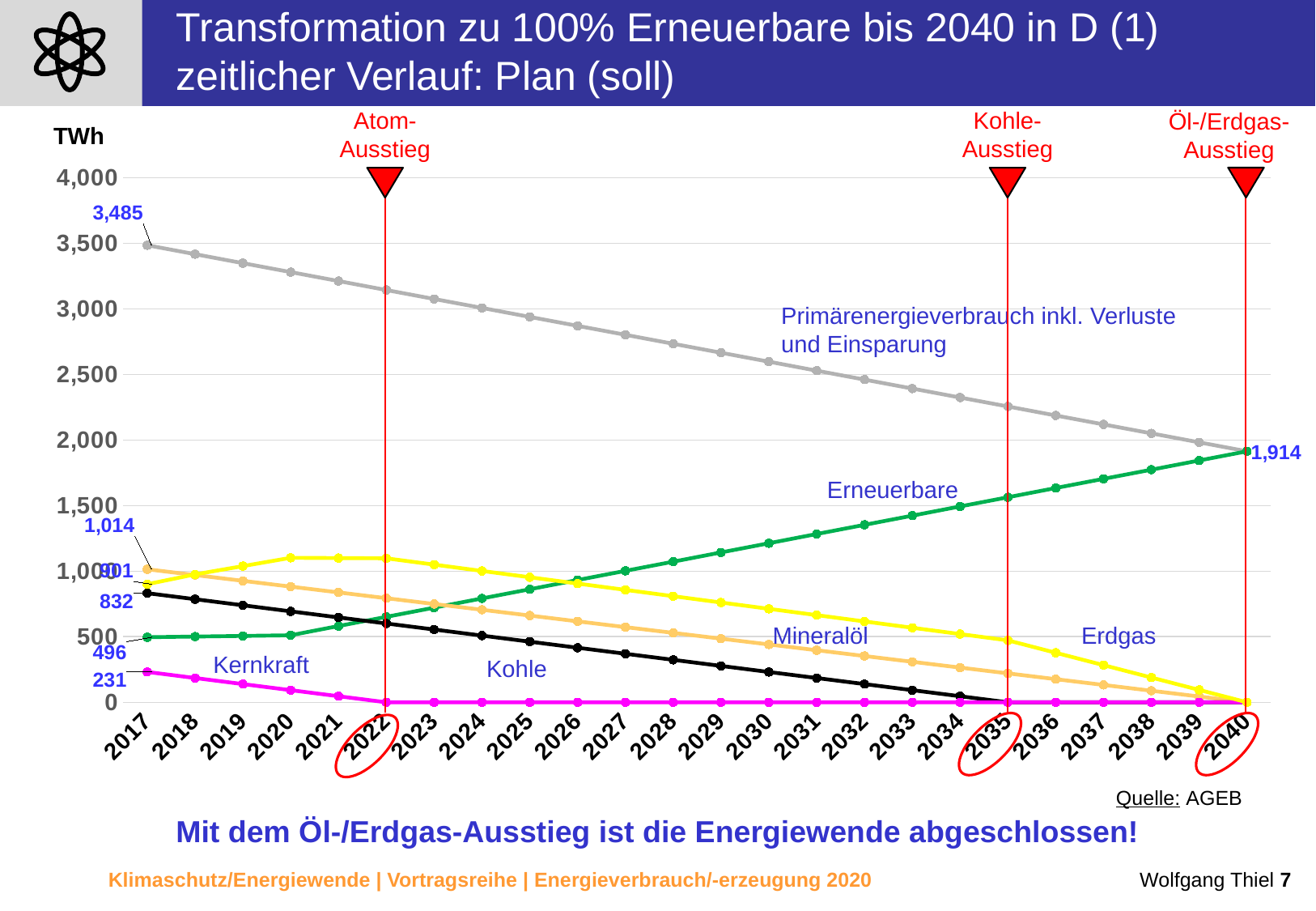
What is the value for Mineralöl in 2017? 1,014 Is the value for Erdgas in 2020 greater or less than 1,000? greater By how much does the Erneuerbare value increase from 2017 (496) to 2040 (1,914)? 1,418 What value does the Erneuerbare line reach in 2040? 1,914 What kind of chart is shown on the slide? line chart In which year is the Kohle-Ausstieg marked on the chart? 2035 What is the value of Primärenergieverbrauch inkl. Verluste und Einsparung in 2017? 3,485 What is the value for Kohle in 2017? 832 How many years are shown on the x axis? 24 What is the value for Kernkraft in 2017? 231 Does the Primärenergieverbrauch line rise or fall from 2017 to 2040? fall In 2017, which is larger: Mineralöl or Kohle? Mineralöl